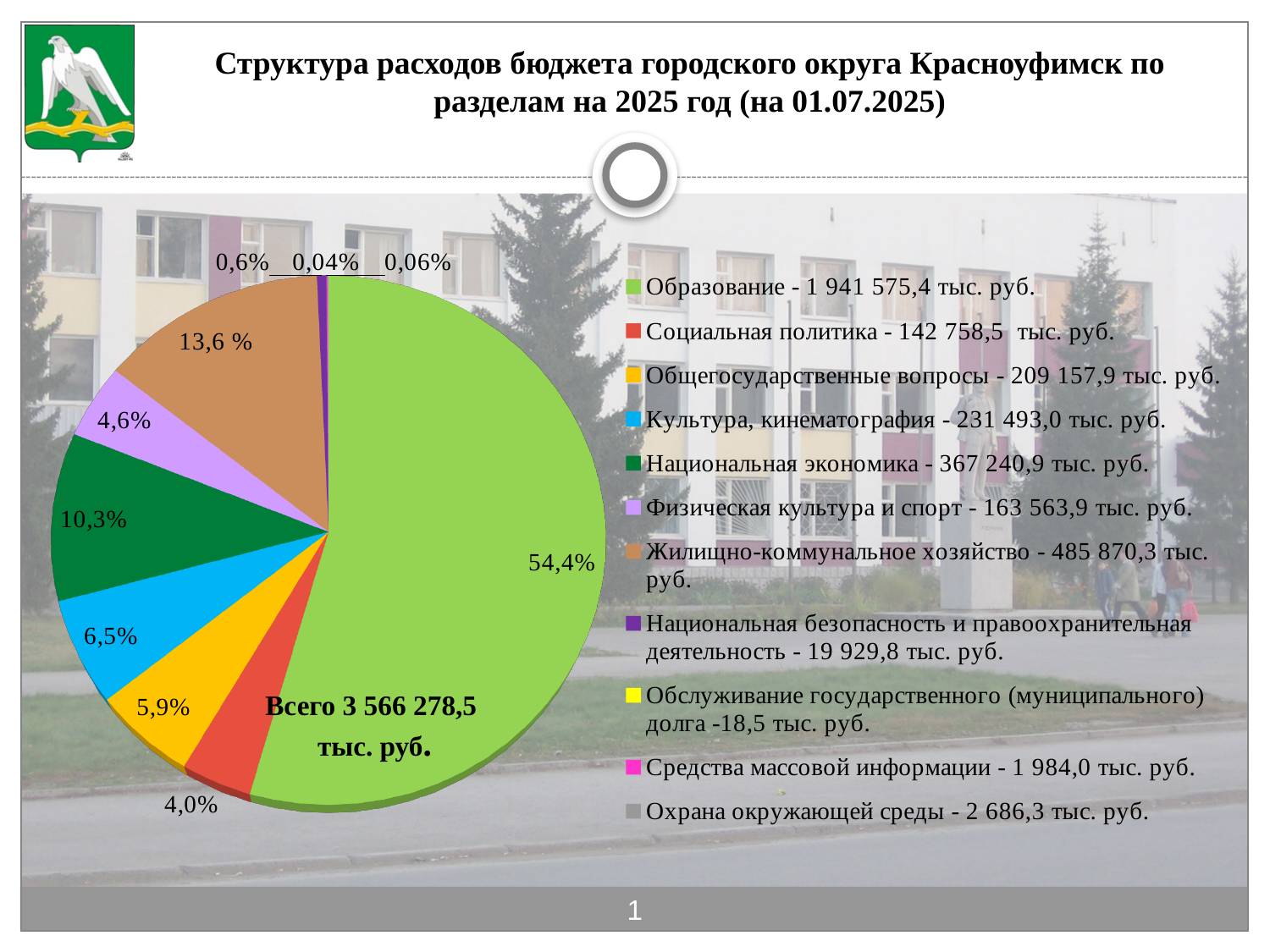
What is the value for Культура, кинематография according to the legend? 231 493,0 тыс. руб. What share of the pie does Национальная экономика take? 10,3% What share of the pie does Образование take? 54,4% What kind of chart is shown on the slide? pie chart What is the difference between the legend values for Культура, кинематография and Общегосударственные вопросы? 22 335,1 тыс. руб. Which category has the largest share of the pie? Образование What is the value for Социальная политика according to the legend? 142 758,5 тыс. руб. Which is larger: Национальная экономика or Физическая культура и спорт? Национальная экономика How many categories does the legend of the pie chart list? 11 What total amount is printed on the pie chart? Всего 3 566 278,5 тыс. руб. Which category has the smallest value in the legend? Обслуживание государственного (муниципального) долга What share of the pie does Жилищно-коммунальное хозяйство take? 13,6 %